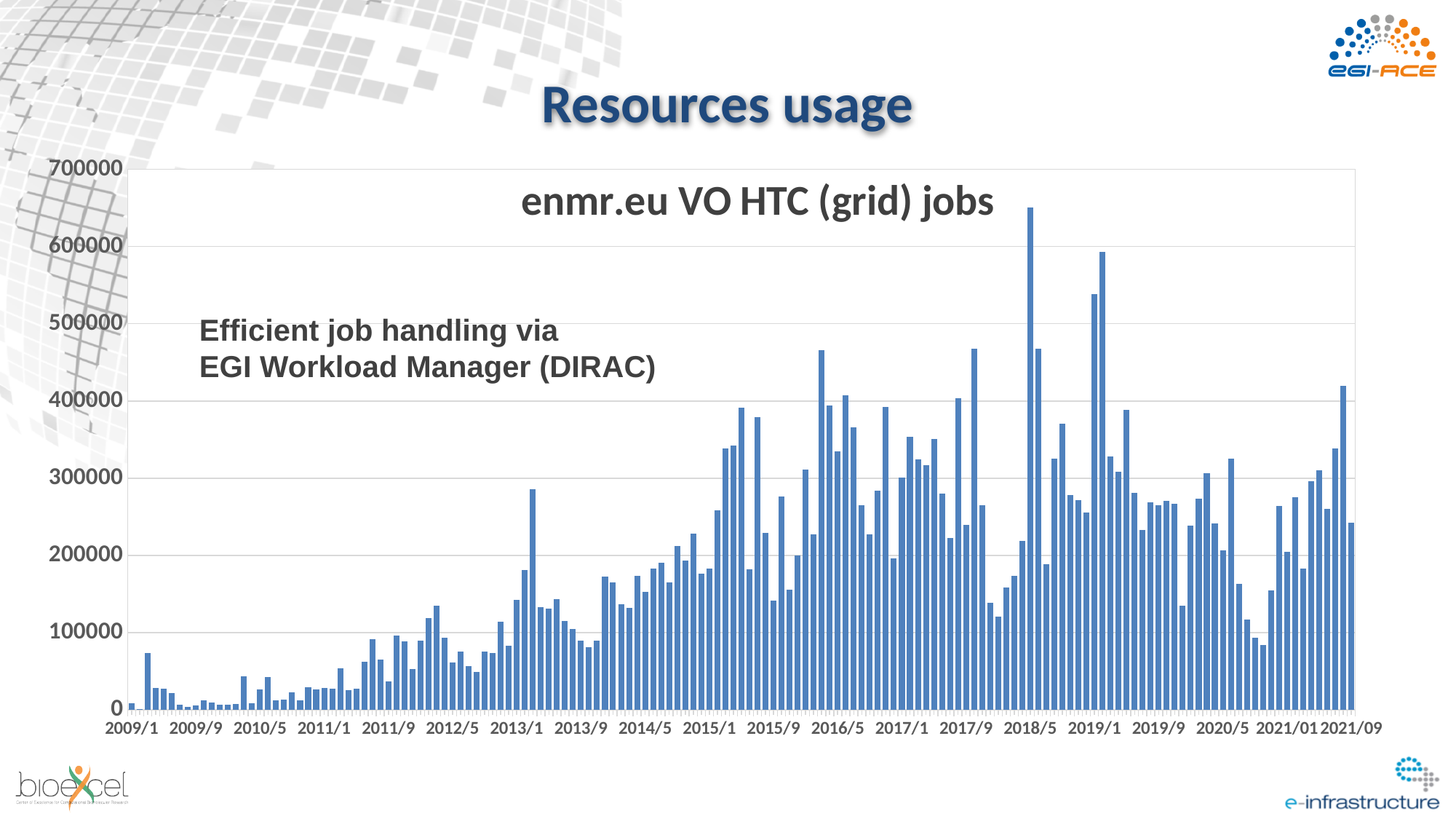
Is the value for 2021/09 greater or less than 300000? less Which has the larger value, 2019/1 or 2020/5? 2019/1 Is the value for 2010/5 greater or less than 100000? less What kind of chart is shown on the slide? bar chart What is the highest value shown on the vertical axis of the chart? 700000 Is the value for 2019/1 greater or less than 500000? greater Which has the larger value, 2009/1 or 2021/09? 2021/09 Overall, do the values rise or fall from 2009/1 to 2021/09? rise What is the title of the chart? enmr.eu VO HTC (grid) jobs